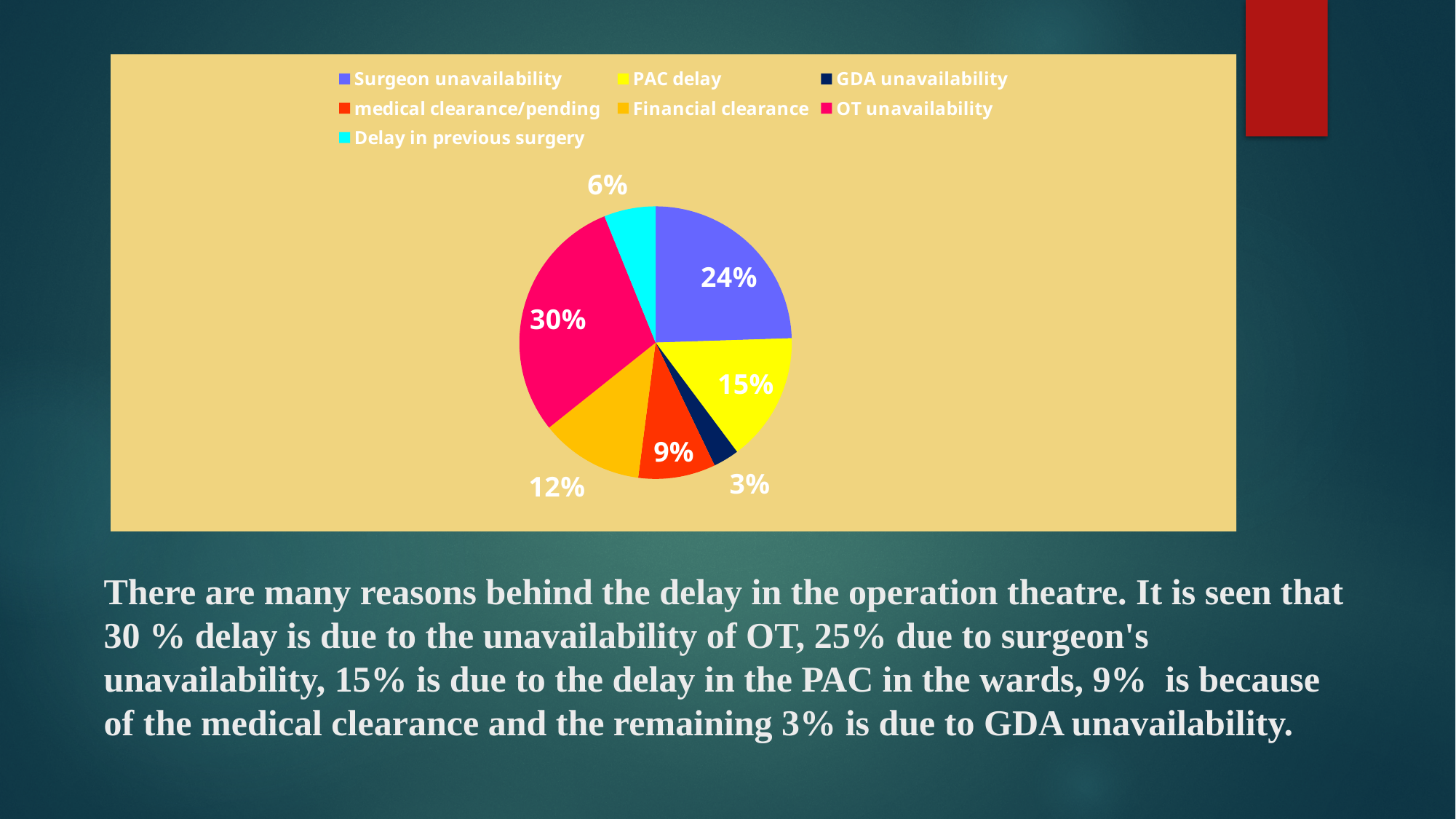
What kind of chart is shown on the slide? pie chart Which category has the largest slice of the pie? OT unavailability Which category has the smallest slice of the pie? GDA unavailability What percentage of the pie is labelled for Delay in previous surgery? 6% What percentage of the pie is labelled for medical clearance/pending? 9% What percentage of the pie is labelled for OT unavailability? 30% Which is larger, the PAC delay slice or the Financial clearance slice? PAC delay What percentage of the pie is labelled for Surgeon unavailability? 24% What percentage of the pie is labelled for Financial clearance? 12% How many categories does the legend list? 7 What is the difference between the OT unavailability slice and the Surgeon unavailability slice? 6% What percentage of the pie is labelled for PAC delay? 15%